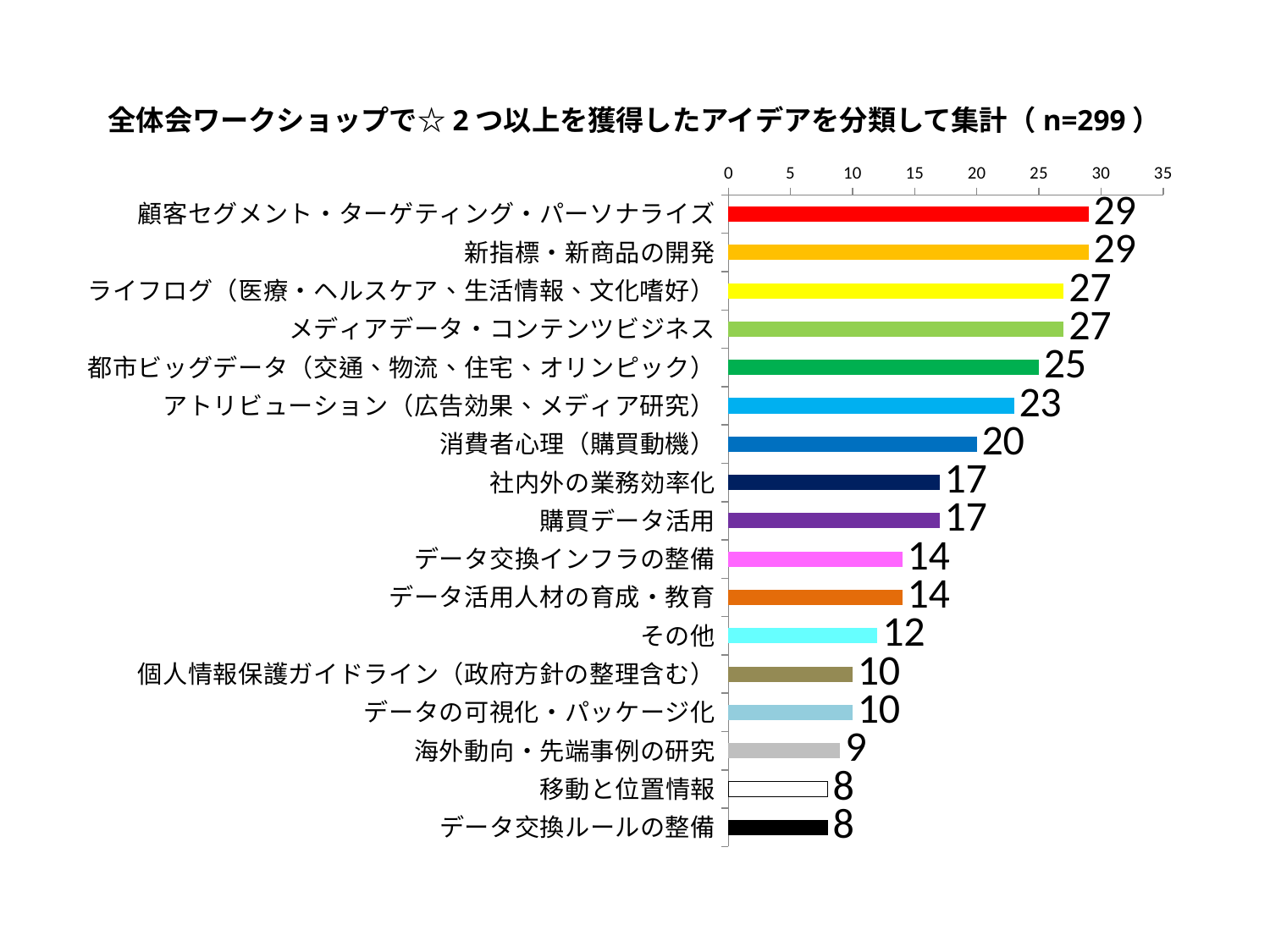
What is the highest value shown in the chart? 29 What kind of chart is shown on the slide? bar chart What sample size (n) is stated in the chart title? n=299 What is the difference between the values for アトリビューション（広告効果、メディア研究） and データ交換ルールの整備? 15 What is the value for 海外動向・先端事例の研究? 9 How many categories are plotted in the chart? 17 Do the values rise or fall going from the top bar to the bottom bar? fall What is the lowest value shown in the chart? 8 What is the value for 消費者心理（購買動機）? 20 Which has a larger value, 社内外の業務効率化 or データ活用人材の育成・教育? 社内外の業務効率化 What is the value for 都市ビッグデータ（交通、物流、住宅、オリンピック）? 25 What is the value for その他? 12